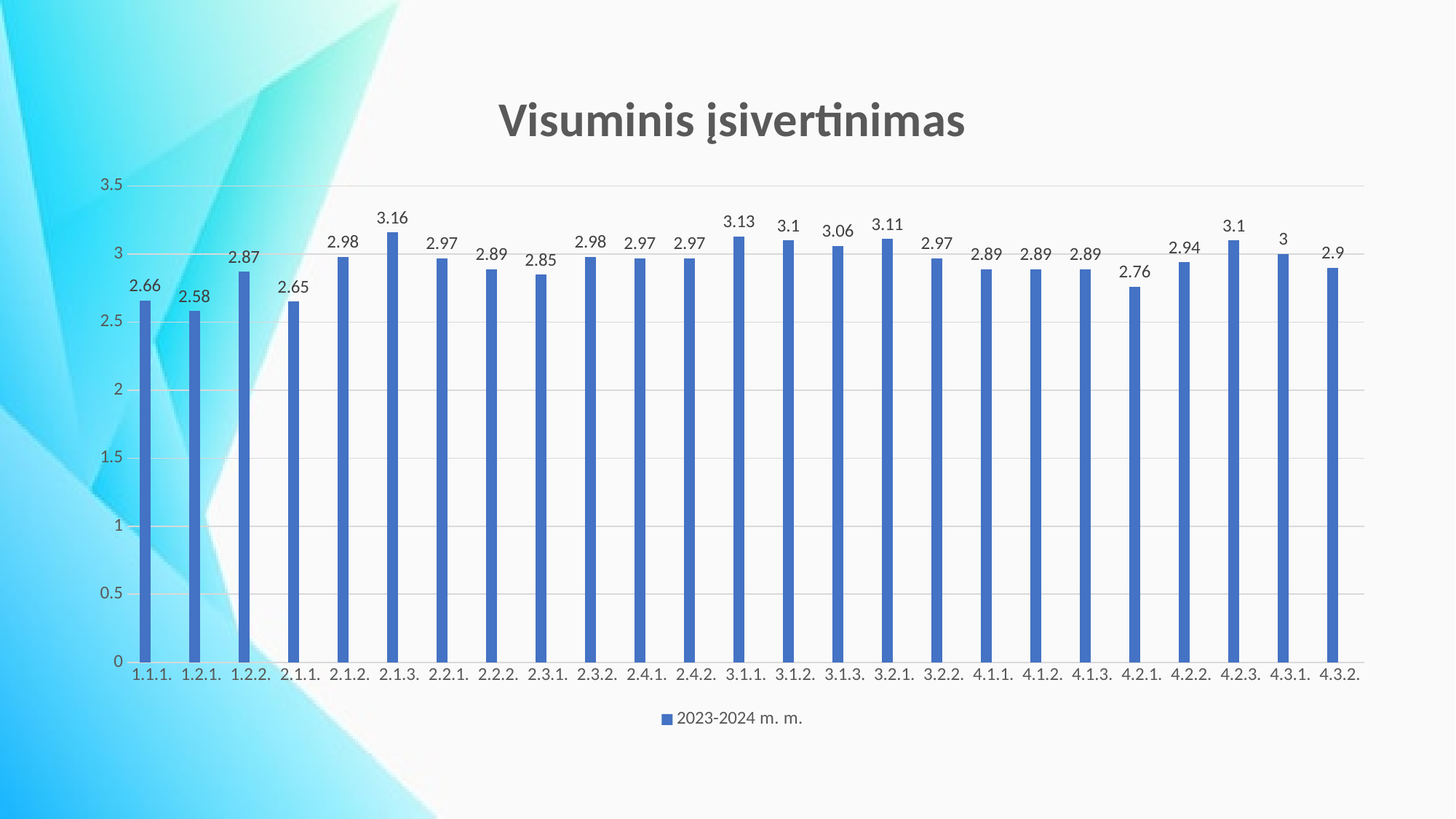
Which category has the highest value? 2.1.3. What is the difference between the values for 2.1.3. and 1.2.1.? 0.58 What kind of chart is shown on the slide? bar chart What series name does the legend show? 2023-2024 m. m. What is the difference between the values for 3.1.1. and 3.1.3.? 0.07 Is the value for 3.2.1. greater or less than 3? greater Which category has the lowest value? 1.2.1. Which is larger, the value for 1.2.2. or the value for 2.1.1.? 1.2.2. What is the value for 4.2.1.? 2.76 What is the value for 2.1.3.? 3.16 How many categories are shown on the x axis? 25 What is the value for 4.3.1.? 3